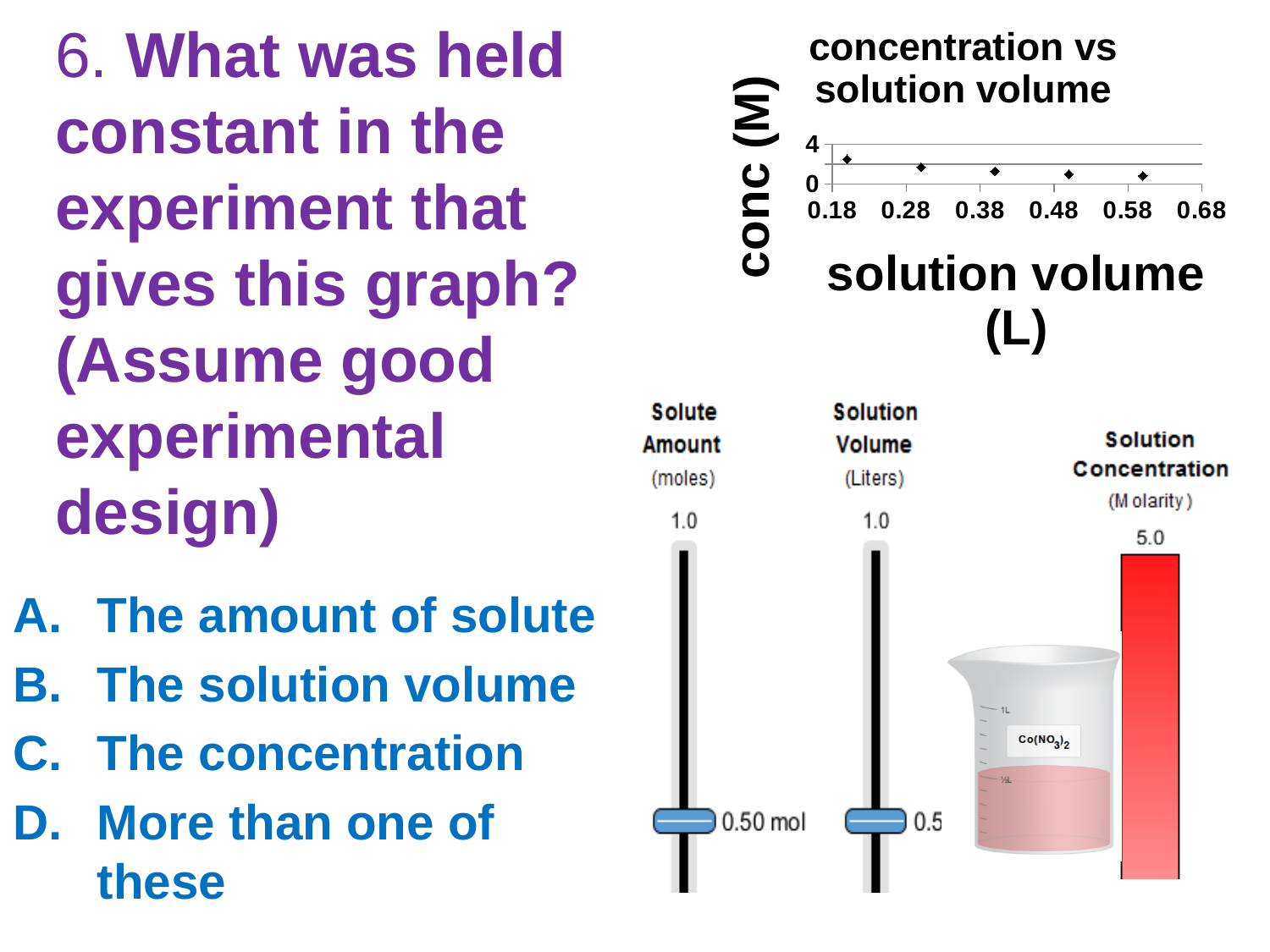
What is the highest value shown on the y axis of the chart? 4 What is the label of the y axis of the chart? conc (M) Is the concentration of the rightmost data point greater or less than 0? greater Which data point has the lowest concentration, the leftmost or the rightmost? the rightmost How many data points are plotted on the chart? 5 Do the concentration values rise or fall as solution volume increases along the x axis? fall Is the concentration of the leftmost data point greater or less than 4? less Which data point has the highest concentration, the leftmost or the rightmost? the leftmost What kind of chart is shown on the slide? scatter chart Which is larger, the concentration of the first point or the concentration of the second point? the first point What is the title of the chart? concentration vs solution volume